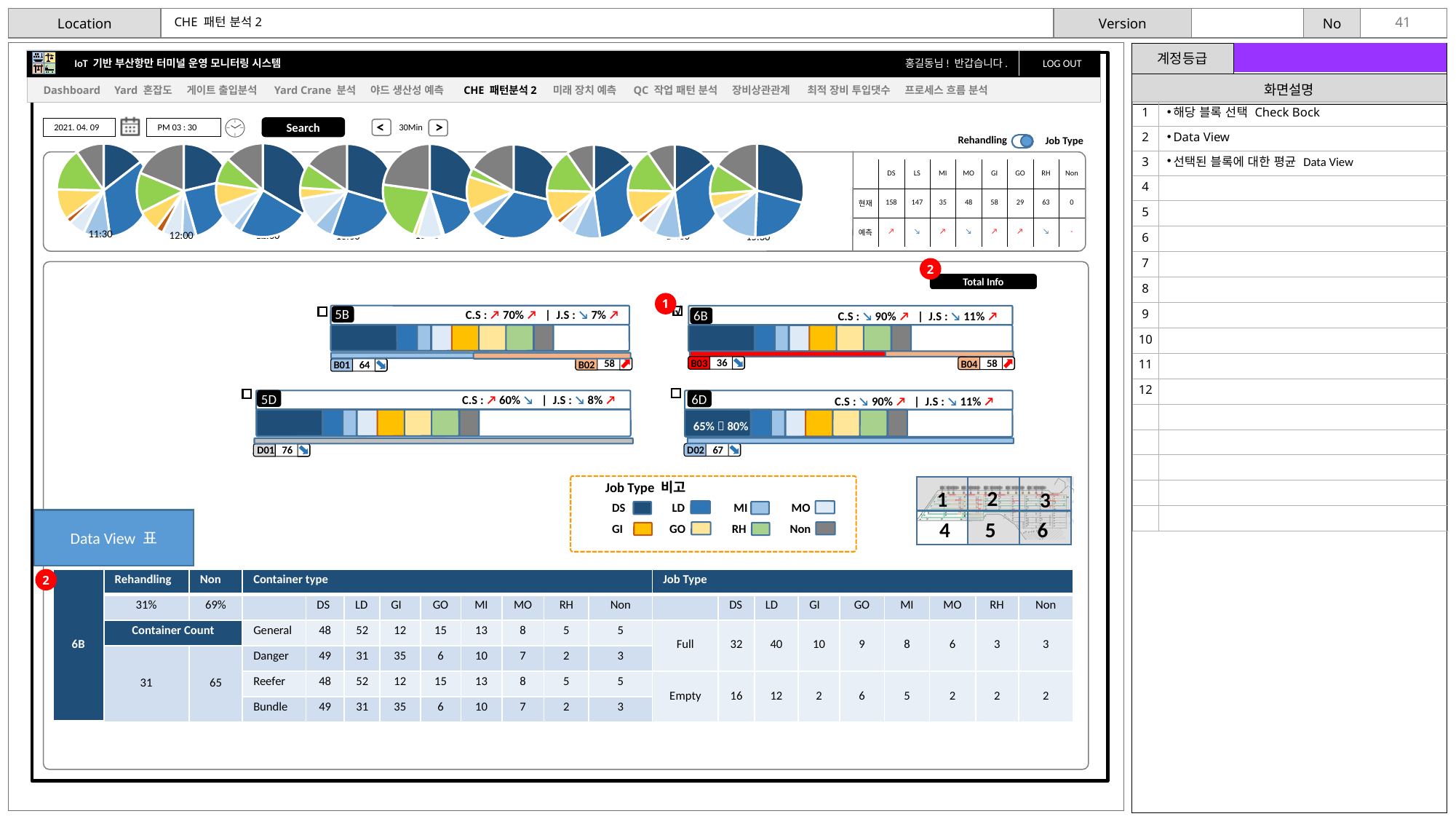
What kind of charts are shown in the row across the top of the dashboard (labelled 11:30, 12:00, ...)? Pie charts Among blocks 5B, 6B, 5D and 6D, which block has the lowest C.S value? 5D In the block bar charts, what is the C.S value shown for block 5B? 70% What value is shown for B03 under the 6B block bar? 36 How many job types does the 'Job Type 비고' legend list? 8 What value is shown for D01 under the 5D block bar? 76 In the block bar charts, what is the C.S value shown for block 5D? 60% How many pie charts are shown in the top row of the dashboard? 9 In the block bar charts, what is the J.S value shown for block 6B? 11% What is the difference between the B01 value (under block 5B) and the B03 value (under block 6B)? 28 Which has the higher J.S value, block 5B or block 5D? 5D What is the difference between the C.S value of block 6B and the C.S value of block 5B? 20%